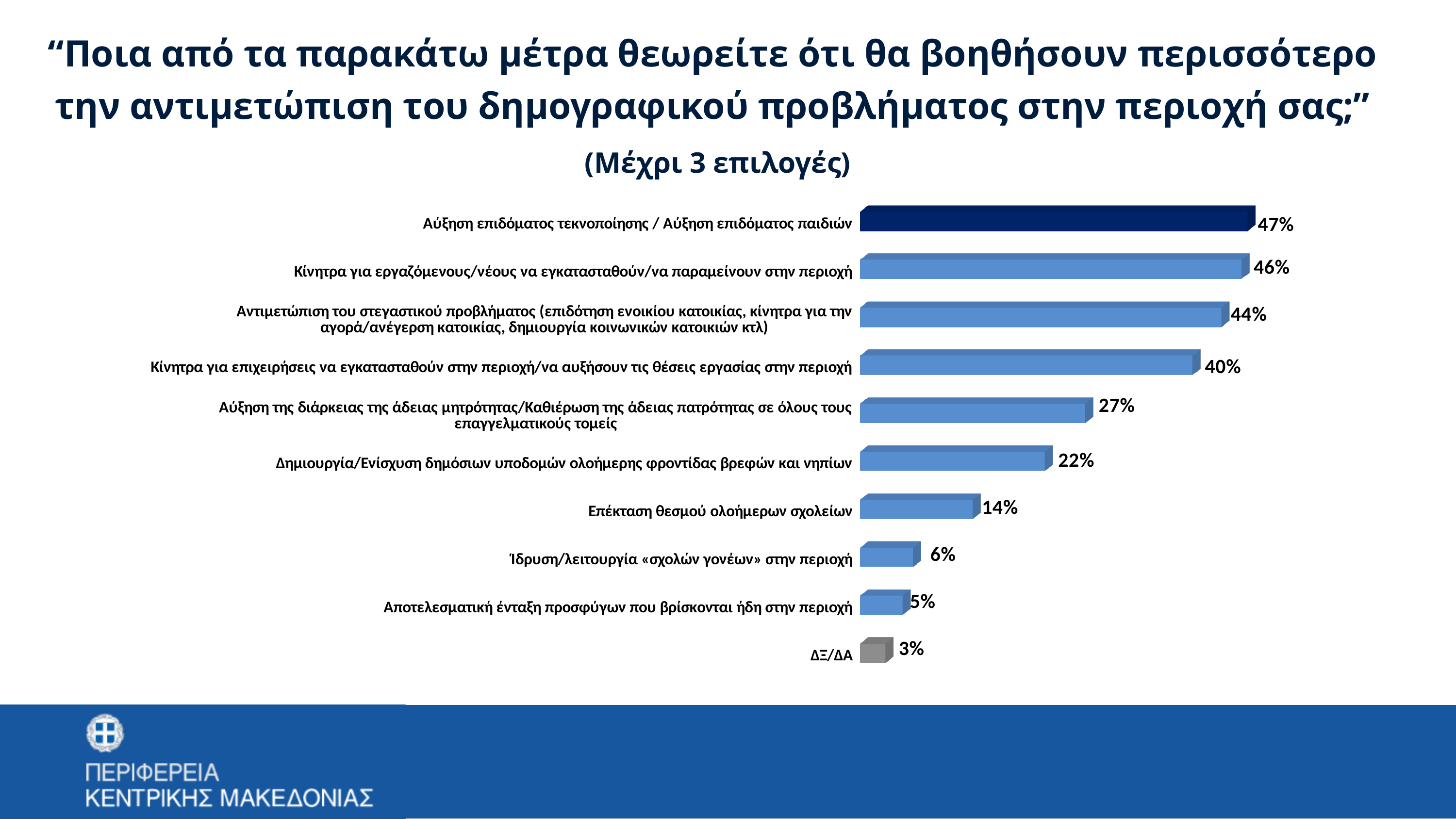
What percentage is shown for "Αύξηση επιδόματος τεκνοποίησης / Αύξηση επιδόματος παιδιών"? 47% What percentage is shown for "ΔΞ/ΔΑ"? 3% What value is shown for "Δημιουργία/Ενίσχυση δημόσιων υποδομών ολοήμερης φροντίδας βρεφών και νηπίων"? 22% Which is larger: the value for "Ίδρυση/λειτουργία «σχολών γονέων» στην περιοχή" or for "Αποτελεσματική ένταξη προσφύγων που βρίσκονται ήδη στην περιοχή"? Ίδρυση/λειτουργία «σχολών γονέων» στην περιοχή Which category has the lowest value? ΔΞ/ΔΑ What value is shown for "Επέκταση θεσμού ολοήμερων σχολείων"? 14% What is the difference between the values for "Κίνητρα για εργαζόμενους/νέους να εγκατασταθούν/να παραμείνουν στην περιοχή" and "Κίνητρα για επιχειρήσεις να εγκατασταθούν στην περιοχή/να αυξήσουν τις θέσεις εργασίας στην περιοχή"? 6% What colour is the bar for "ΔΞ/ΔΑ"? Grey How many categories are shown in the chart? 10 What kind of chart is shown on the slide? Bar chart What is the difference between the values for "Αύξηση της διάρκειας της άδειας μητρότητας/Καθιέρωση της άδειας πατρότητας σε όλους τους επαγγελματικούς τομείς" and "Επέκταση θεσμού ολοήμερων σχολείων"? 13% Which category has the highest value? Αύξηση επιδόματος τεκνοποίησης / Αύξηση επιδόματος παιδιών